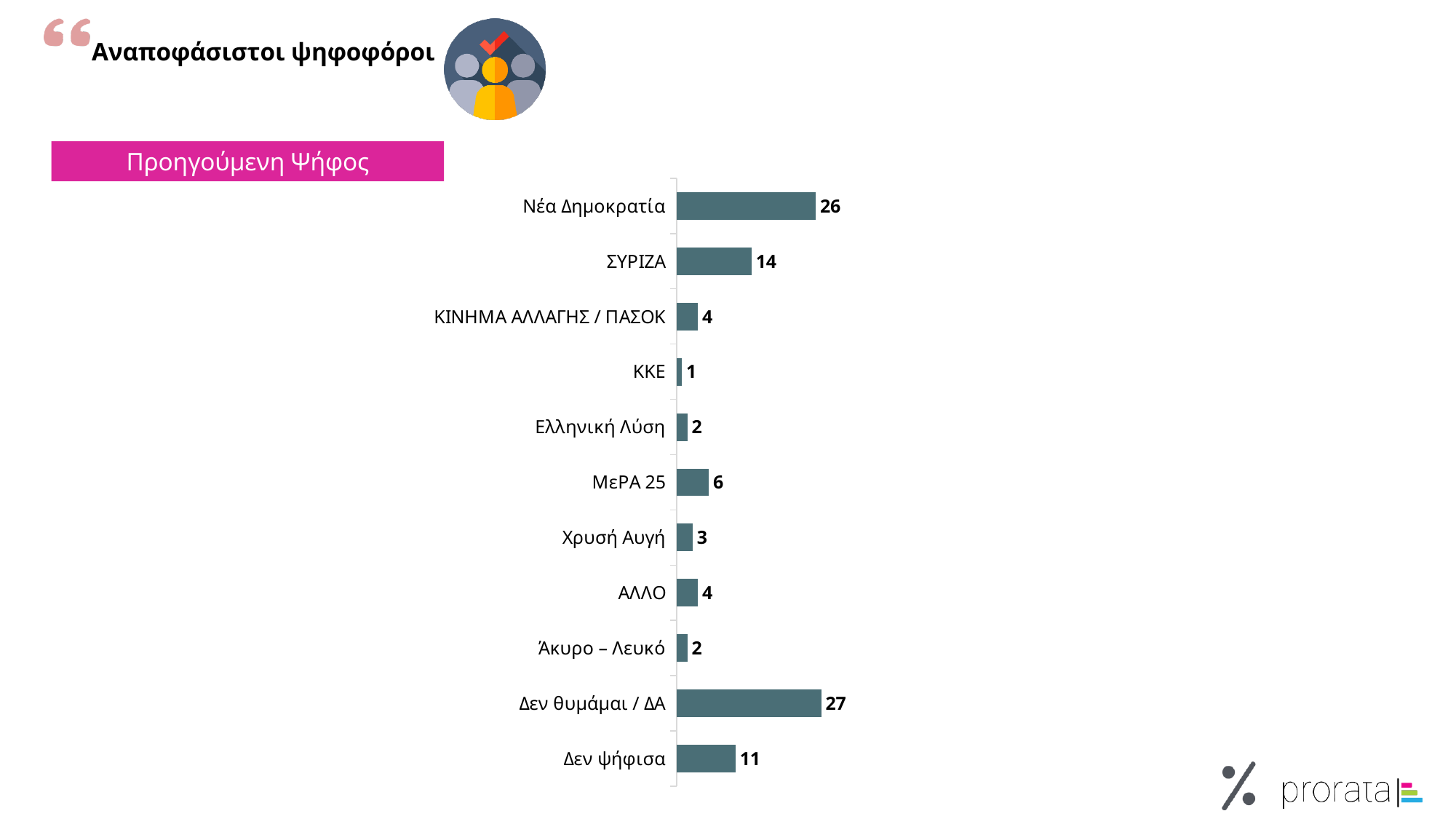
Which category has the lowest value? ΚΚΕ What is the value for Νέα Δημοκρατία? 26 What is the title shown in the pink box above the chart? Προηγούμενη Ψήφος What is the value for ΣΥΡΙΖΑ? 14 What kind of chart is shown on the slide? Bar chart What is the value for Δεν ψήφισα? 11 What is the difference between the values for Δεν θυμάμαι / ΔΑ and Δεν ψήφισα? 16 What is the value for ΜεΡΑ 25? 6 What is the difference between the values for Νέα Δημοκρατία and ΣΥΡΙΖΑ? 12 Which category has the highest value? Δεν θυμάμαι / ΔΑ How many categories are shown in the chart? 11 Which is larger, the value for ΜεΡΑ 25 or the value for Χρυσή Αυγή? ΜεΡΑ 25